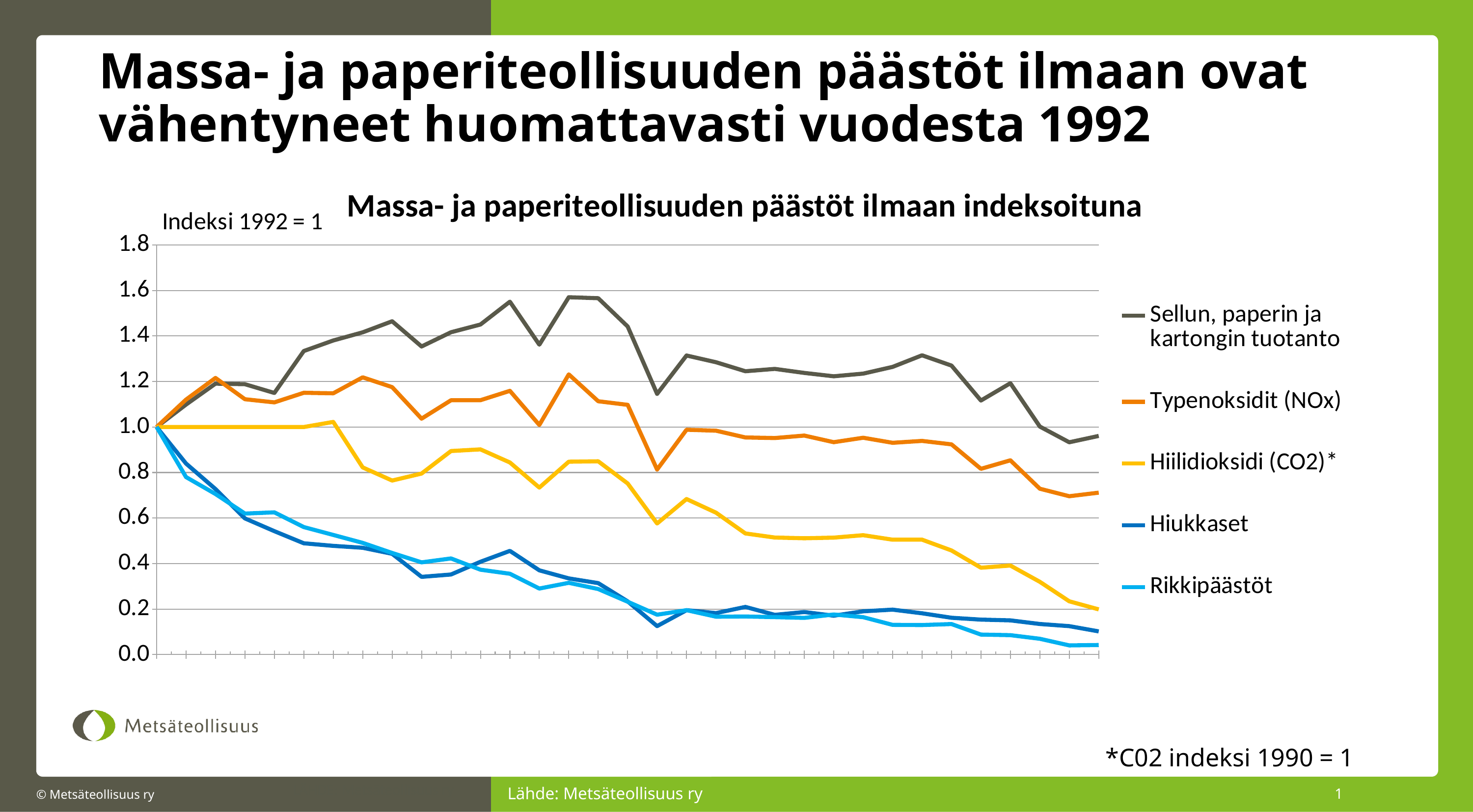
What kind of chart is shown on the slide? line chart At the right end of the chart, which is higher: Typenoksidit (NOx) or Hiilidioksidi (CO2)*? Typenoksidit (NOx) How many series does the chart legend list? 5 Which series has the highest value at the right end of the chart? Sellun, paperin ja kartongin tuotanto Do the values for Rikkipäästöt rise or fall along the x axis overall? fall Is the highest value reached by the Sellun, paperin ja kartongin tuotanto series greater or less than 1.4? greater Do the values for Hiilidioksidi (CO2)* rise or fall along the x axis overall? fall What is the title of the chart? Massa- ja paperiteollisuuden päästöt ilmaan indeksoituna Is the value for Typenoksidit (NOx) at the right end of the chart greater or less than 0.8? less Is the value for Hiilidioksidi (CO2)* at the right end of the chart greater or less than 0.4? less Which series is drawn in yellow in the chart? Hiilidioksidi (CO2)*